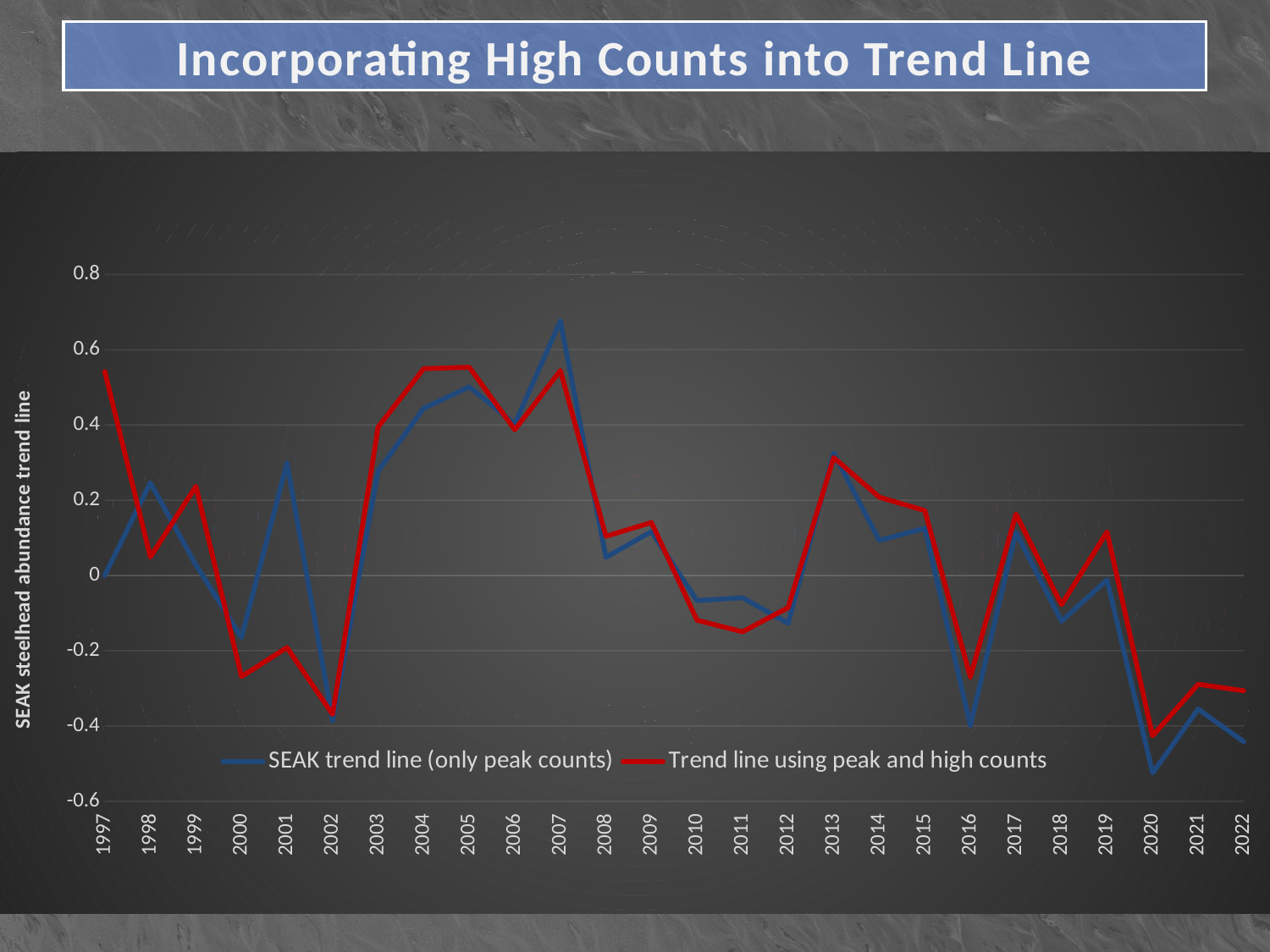
How many years are plotted along the x axis? 26 Is the value of the Trend line using peak and high counts in 2000 greater or less than -0.2? less In 1997, which series has the higher value: the SEAK trend line (only peak counts) or the Trend line using peak and high counts? Trend line using peak and high counts What kind of chart is shown on the slide? line chart Which series is drawn in red? Trend line using peak and high counts In which year does the SEAK trend line (only peak counts) reach its lowest value? 2020 Is the value of the Trend line using peak and high counts in 2003 greater or less than 0.2? greater In 2001, which series has the higher value: the SEAK trend line (only peak counts) or the Trend line using peak and high counts? SEAK trend line (only peak counts) How many series does the legend list? 2 In which year does the SEAK trend line (only peak counts) reach its highest value? 2007 Is the value of the SEAK trend line (only peak counts) in 2007 greater or less than 0.6? greater What is the label of the y axis? SEAK steelhead abundance trend line